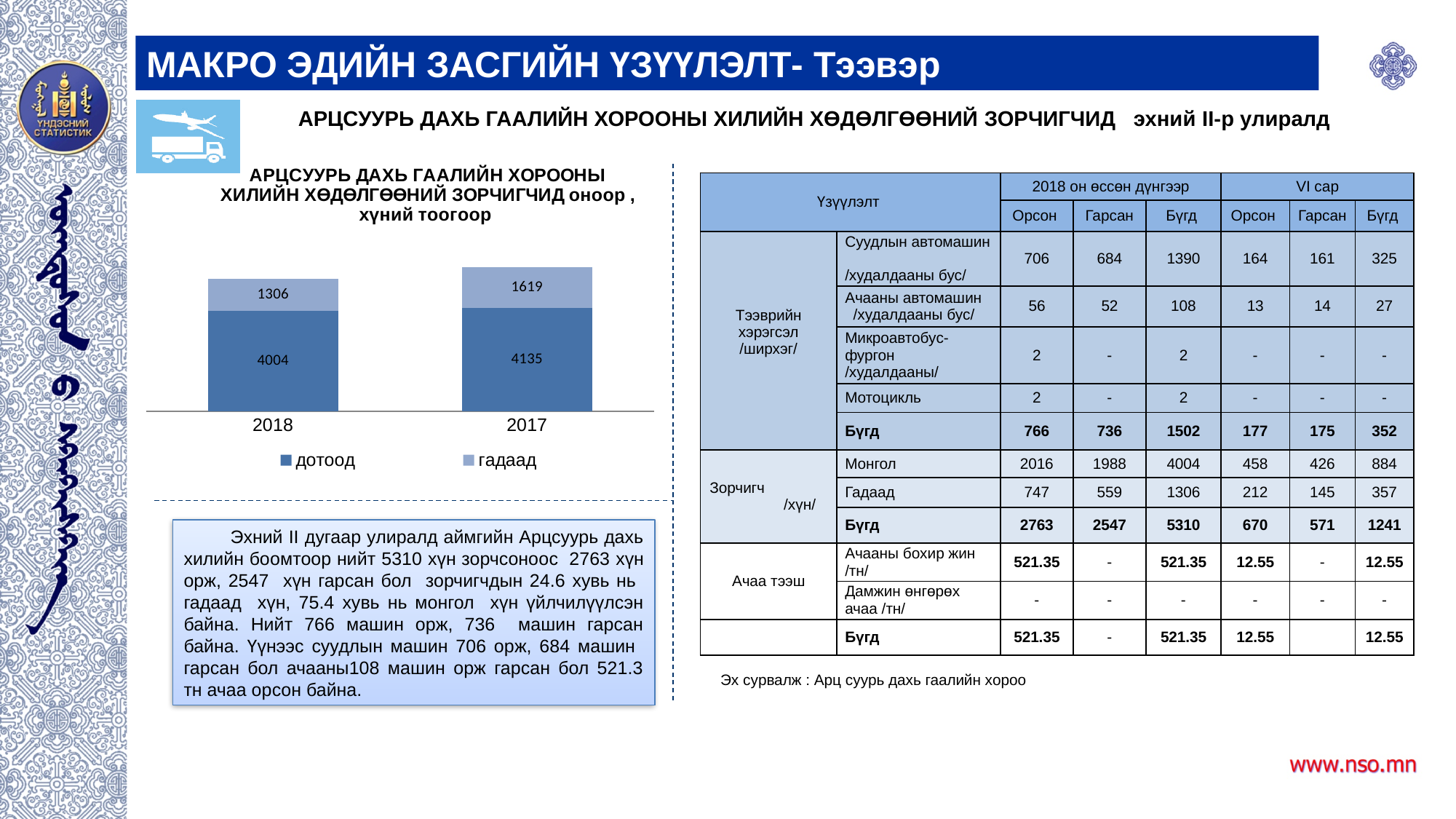
How many categories are shown on the x axis? 2 What is the total of the stacked bar for 2018? 5310 What is the difference between the гадаад values for 2017 and 2018? 313 What is the value for гадаад in 2018? 1306 What is the total of the stacked bar for 2017? 5754 What is the value for дотоод in 2018? 4004 What type of chart is shown on the slide? bar chart Which year has the larger дотоод value, 2018 or 2017? 2017 What is the value for дотоод in 2017? 4135 How many series does the legend list? 2 What is the value for гадаад in 2017? 1619 Which series is shown in the darker blue colour? дотоод